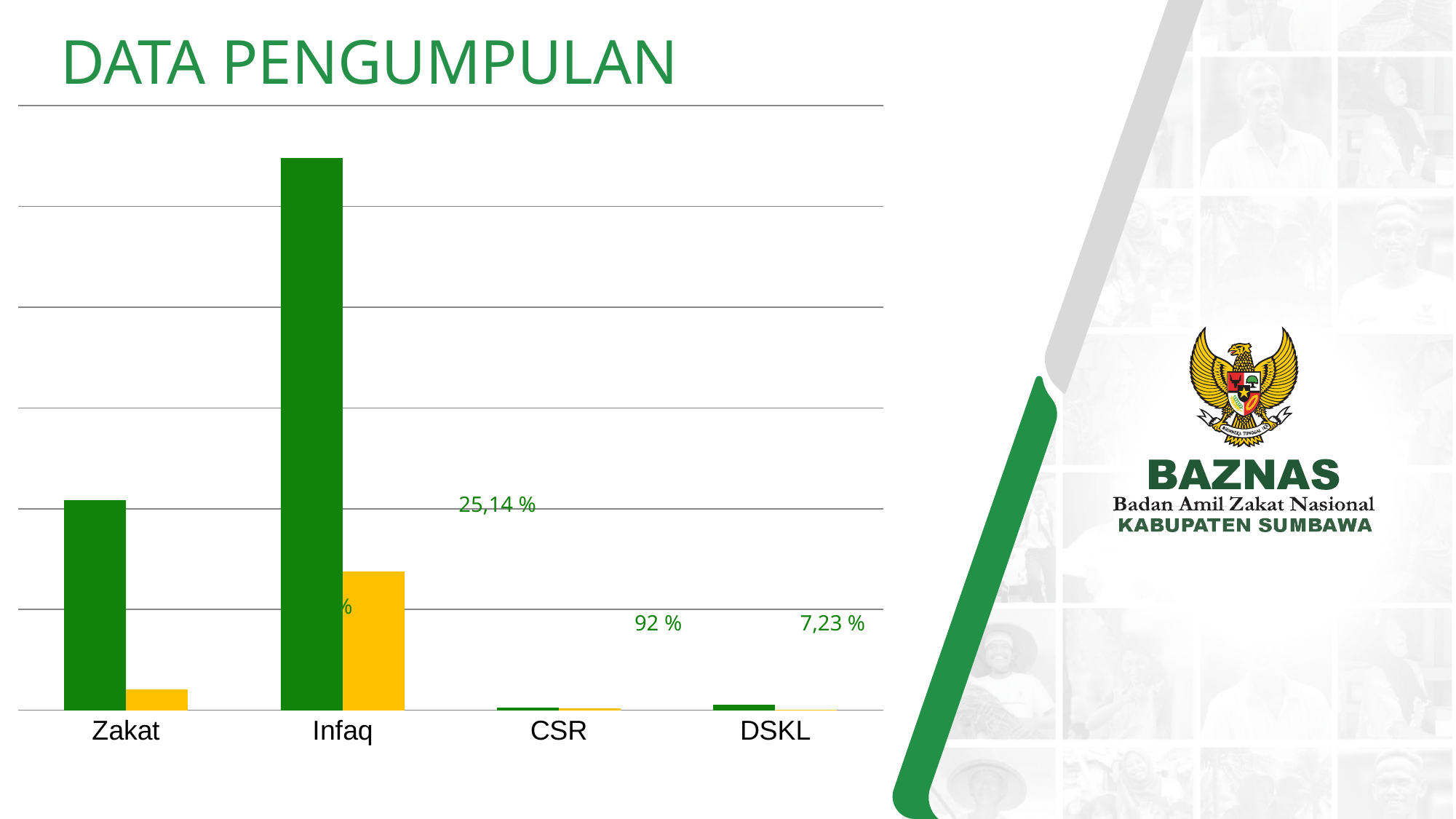
Which category has the tallest yellow bar? Infaq Which category has the shortest green bar? CSR For Zakat, which bar is taller, the green one or the yellow one? green Which category has the tallest green bar? Infaq What kind of chart is shown on the slide? bar chart How many bars are plotted for each category? 2 Is the green bar for Zakat taller or shorter than the green bar for Infaq? shorter Is the green bar for DSKL taller or shorter than the green bar for CSR? taller How many categories are shown on the x axis of the chart? 4 What is the title of the slide containing the chart? DATA PENGUMPULAN What two colours are used for the bars in the chart? green and yellow